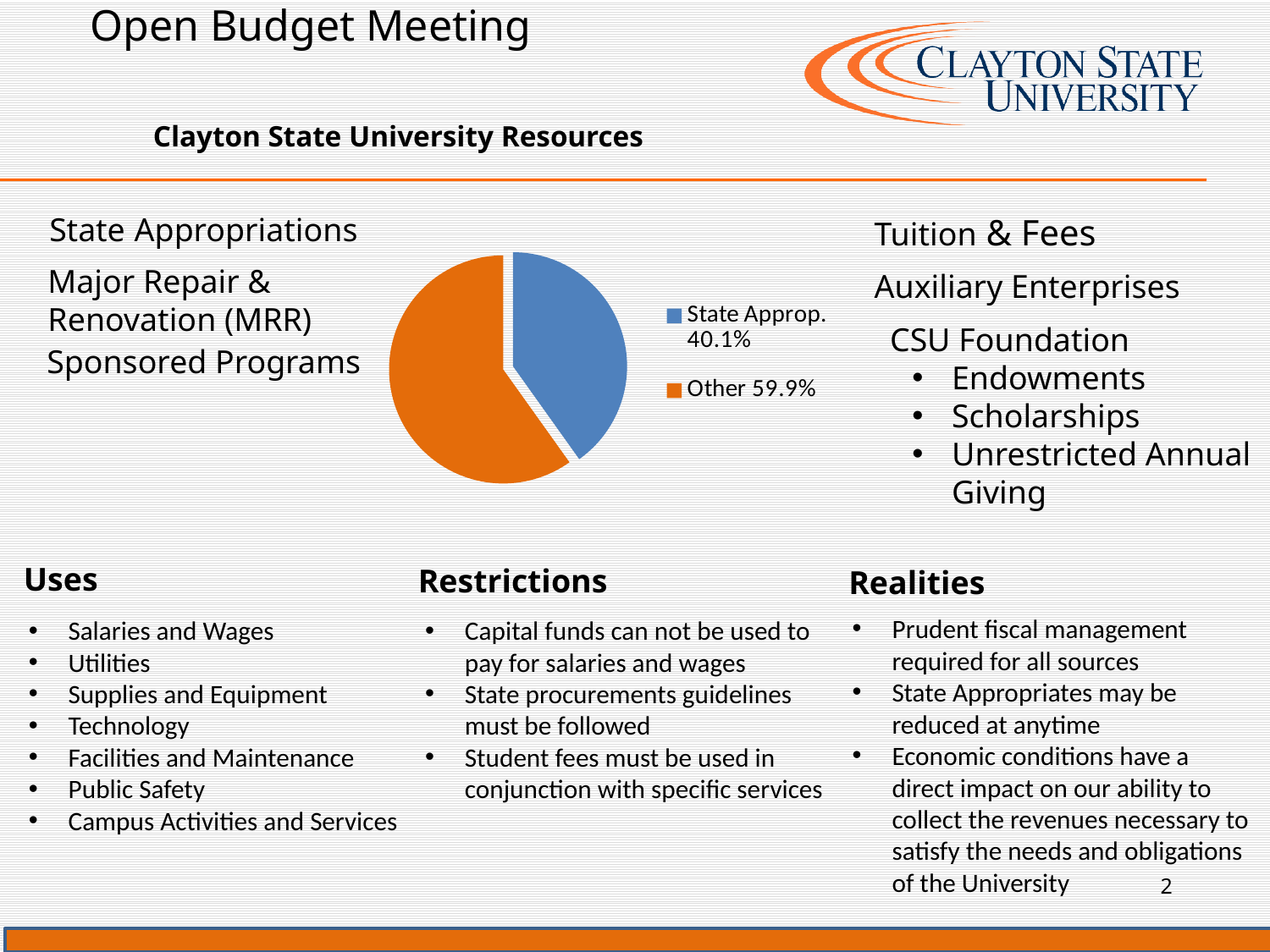
Which slice of the pie chart is the largest? Other How many entries does the pie chart's legend list? 2 Is the share for State Approp. greater or less than 50%? less What kind of chart is shown on the slide? pie chart What share of the pie does State Approp. represent? 40.1% What colour is the State Approp. slice in the pie chart? blue What colour is the Other slice in the pie chart? orange What is the difference in percentage points between the Other slice and the State Approp. slice? 19.8% Which is larger, the State Approp. slice or the Other slice? Other How many slices does the pie chart have? 2 What share of the pie does Other represent? 59.9% Which slice of the pie chart is the smallest? State Approp.